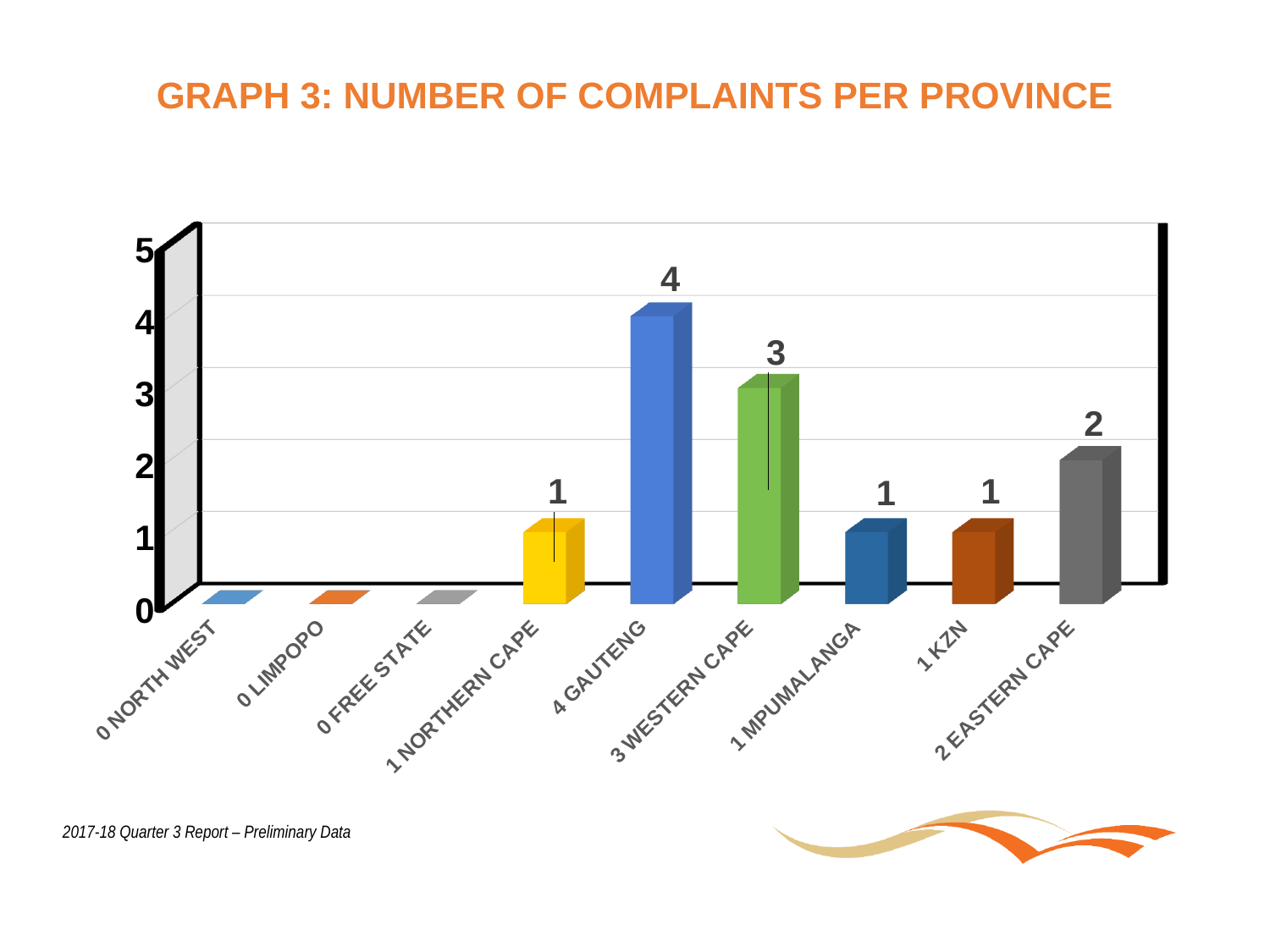
What is the title of the chart? GRAPH 3: NUMBER OF COMPLAINTS PER PROVINCE How many complaints does the chart show for Western Cape? 3 How many complaints does the chart show for Eastern Cape? 2 What kind of chart is shown on the slide? Bar chart What is the difference in complaints between Western Cape and Eastern Cape? 1 How many provinces have 0 complaints? 3 What is the difference in complaints between Gauteng and Western Cape? 1 How many complaints does the chart show for Limpopo? 0 How many complaints does the chart show for Gauteng? 4 Which has more complaints, Eastern Cape or KZN? Eastern Cape Which province has the highest number of complaints? Gauteng How many provinces are shown on the x axis of the chart? 9